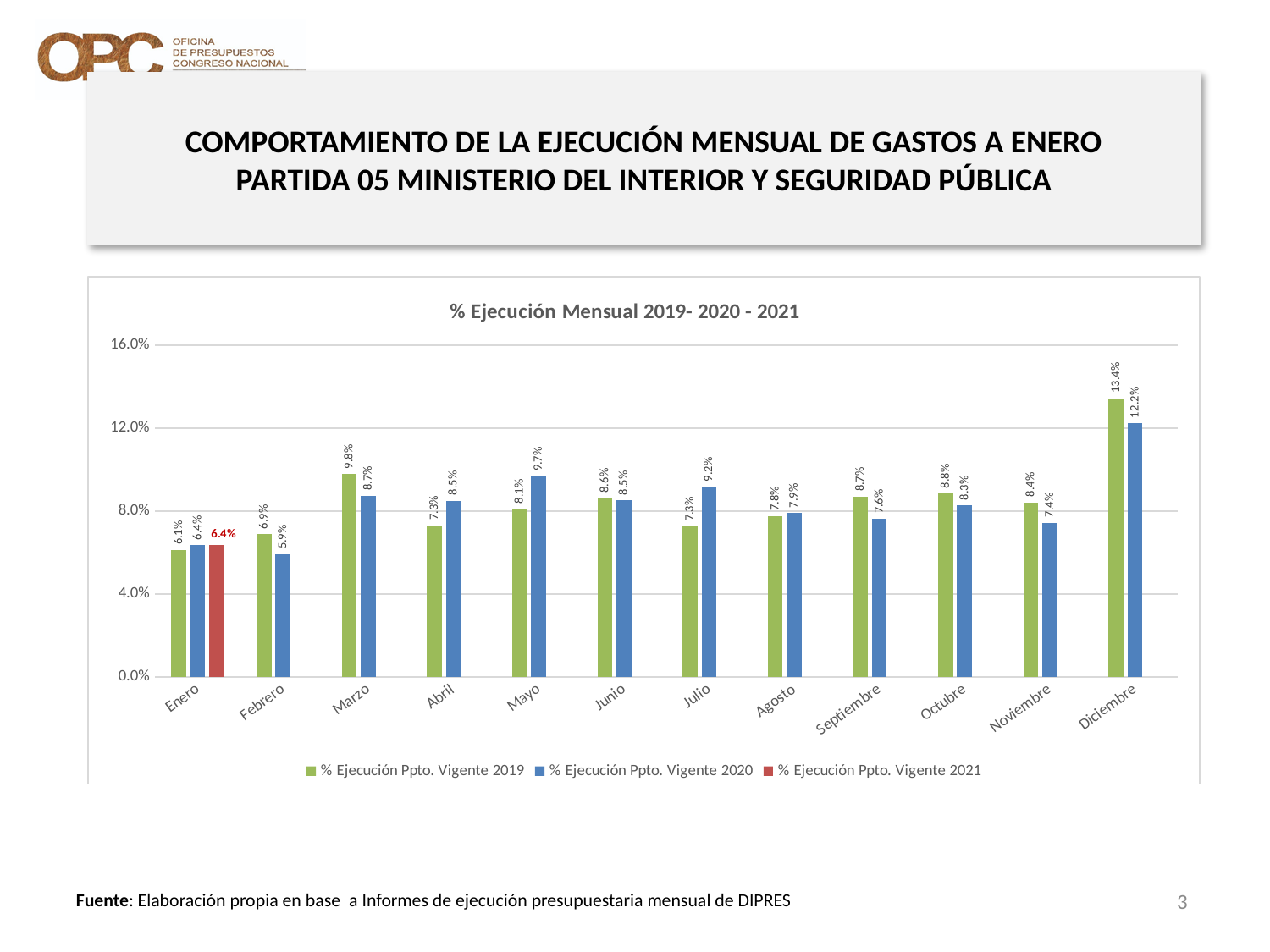
How many months are shown on the x axis? 12 Which month has the highest value in the % Ejecución Ppto. Vigente 2019 series? Diciembre What is the value for Marzo in the % Ejecución Ppto. Vigente 2019 series? 9.8% Which is larger for Julio: the % Ejecución Ppto. Vigente 2019 value or the % Ejecución Ppto. Vigente 2020 value? % Ejecución Ppto. Vigente 2020 What is the title of the chart? % Ejecución Mensual 2019- 2020 - 2021 What kind of chart is shown on the slide? Bar chart What is the value for Enero in the % Ejecución Ppto. Vigente 2021 series? 6.4% Which month has the lowest value in the % Ejecución Ppto. Vigente 2020 series? Febrero Is the value for Diciembre in the % Ejecución Ppto. Vigente 2019 series greater or less than 12.0%? greater What is the difference between the 2019 and 2020 values for Diciembre? 1.2% What is the value for Mayo in the % Ejecución Ppto. Vigente 2020 series? 9.7% How many series does the legend list? 3